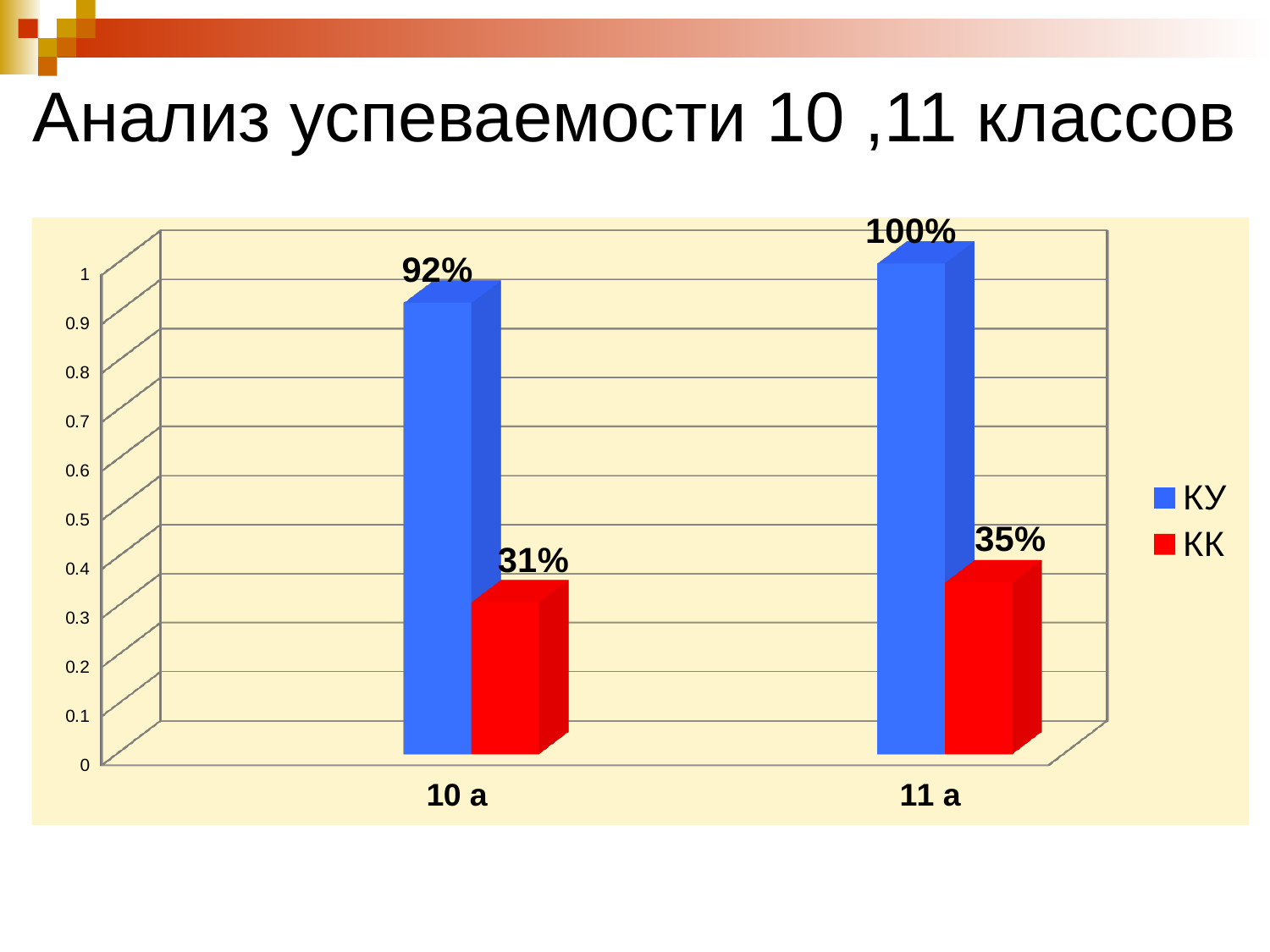
What kind of chart is shown on the slide? Bar chart What is the difference between the КК values for 11 а and 10 а? 4% How many classes are shown on the x axis? 2 What is the difference between the КУ values for 11 а and 10 а? 8% Which is larger for 10 а: КУ or КК? КУ Which class has the higher КУ value? 11 а What is the КК value for 10 а? 31% What is the КК value for 11 а? 35% Which class has the lower КК value? 10 а How many series does the legend list? 2 What is the КУ value for 11 а? 100% What is the КУ value for 10 а? 92%